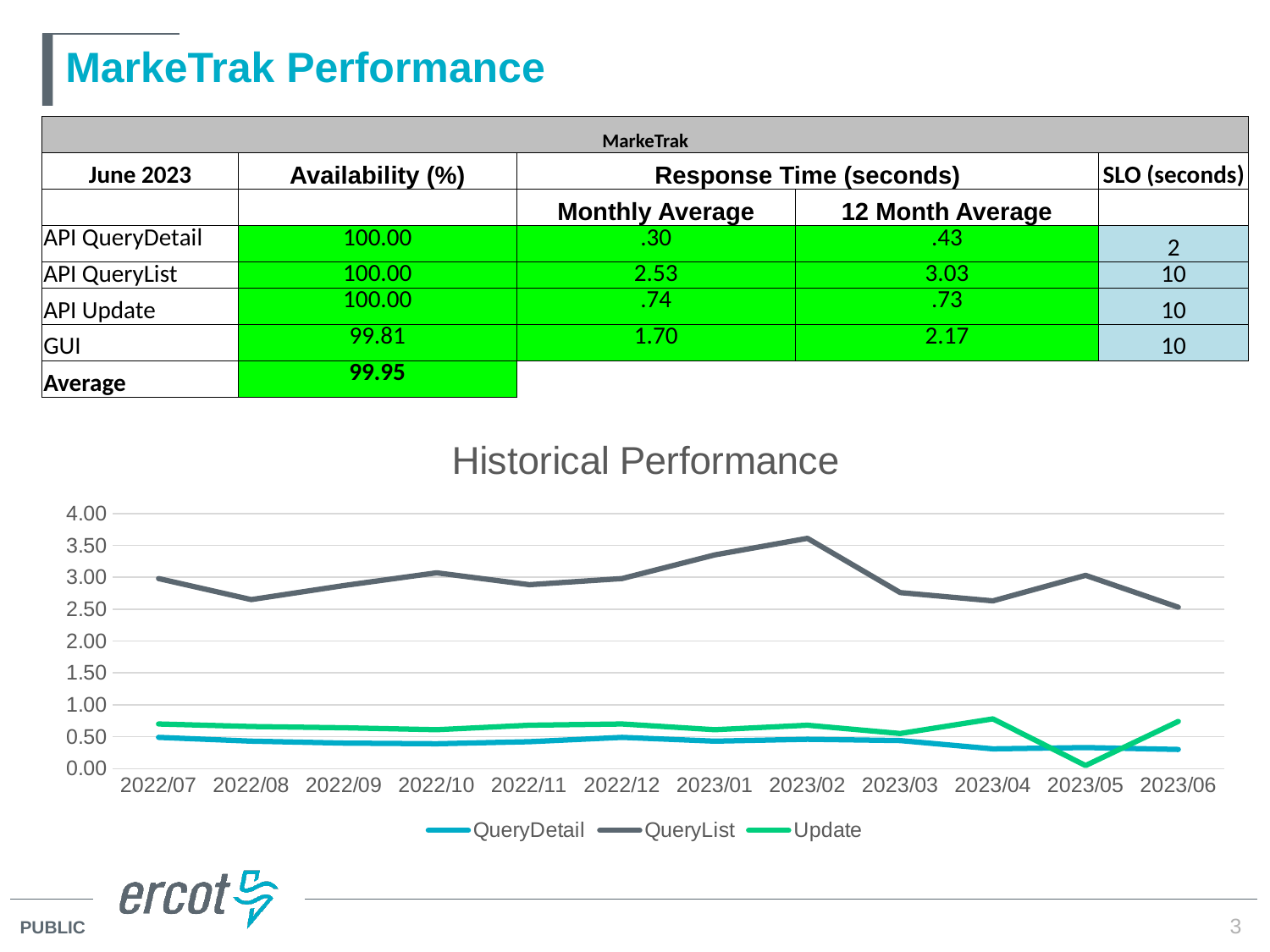
What kind of chart is the Historical Performance chart? line chart What is the title of the chart on the slide? Historical Performance In the Historical Performance chart, which month has the highest QueryList value? 2023/02 In the Historical Performance chart, is the Update value for 2023/05 greater or less than 0.50? less In the Historical Performance chart, is the QueryList value for 2023/02 greater or less than 3.00? greater In the Historical Performance chart, which month has the lowest Update value? 2023/05 In the Historical Performance chart, does the QueryList line rise or fall from 2023/05 to 2023/06? fall How many series does the legend of the Historical Performance chart list? 3 In the Historical Performance chart, which series is larger at 2022/07, QueryList or Update? QueryList In the Historical Performance chart, is the QueryList value for 2022/08 greater or less than 3.00? less In the Historical Performance chart, does the Update line rise or fall from 2023/05 to 2023/06? rise How many months are shown on the x axis of the Historical Performance chart? 12